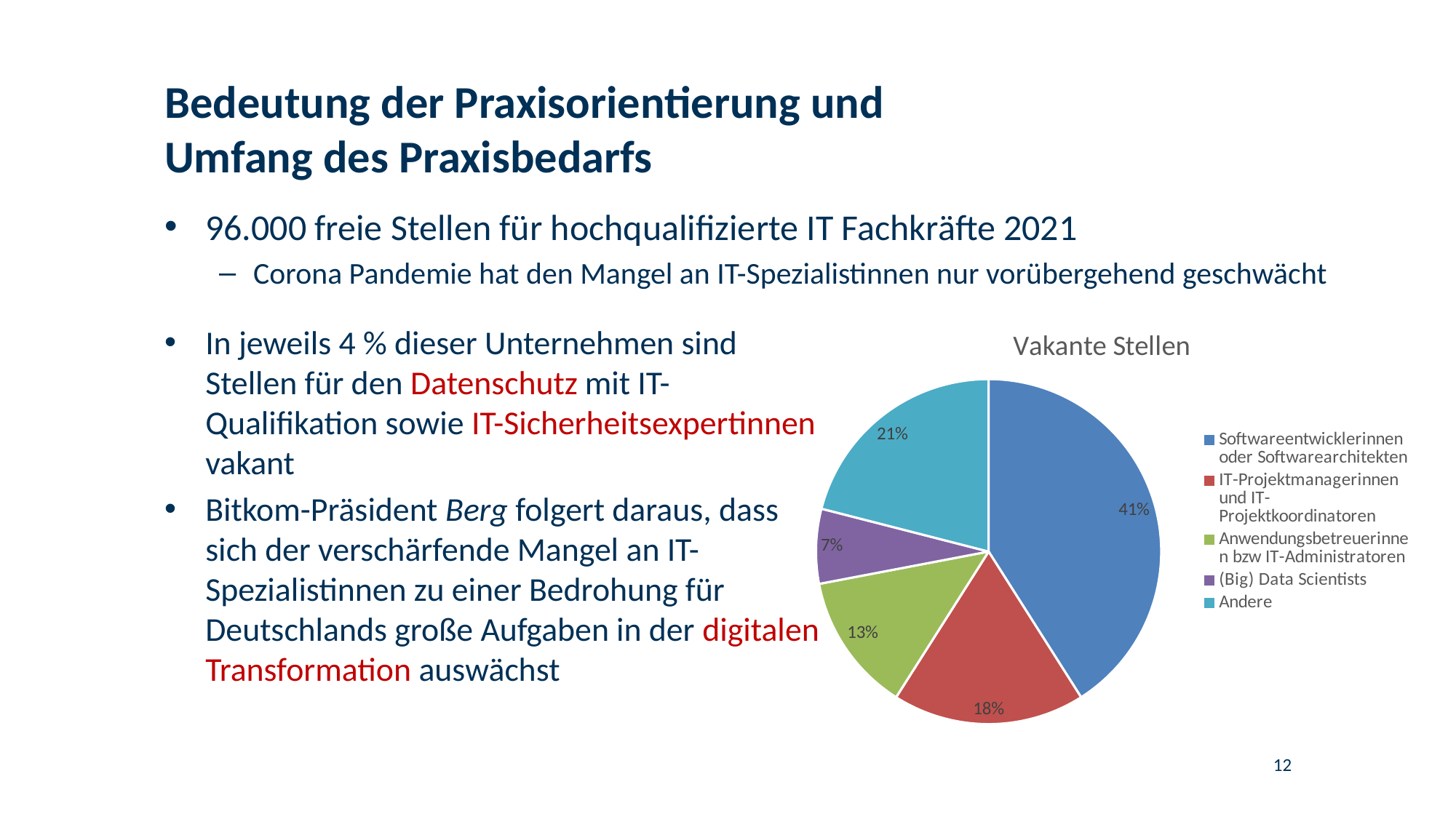
What share of the pie is labelled for Softwareentwicklerinnen oder Softwarearchitekten? 41% Which slice is larger: IT-Projektmanagerinnen und IT-Projektkoordinatoren or Anwendungsbetreuerinnen bzw IT-Administratoren? IT-Projektmanagerinnen und IT-Projektkoordinatoren What share of the pie is labelled for (Big) Data Scientists? 7% What is the title of the chart? Vakante Stellen How many categories does the legend list? 5 Which category has the smallest slice of the pie? (Big) Data Scientists What kind of chart is shown on the slide? pie chart What share of the pie is labelled for Anwendungsbetreuerinnen bzw IT-Administratoren? 13% Which category has the largest slice of the pie? Softwareentwicklerinnen oder Softwarearchitekten What is the difference in percentage points between the Softwareentwicklerinnen oder Softwarearchitekten slice and the Andere slice? 20 percentage points